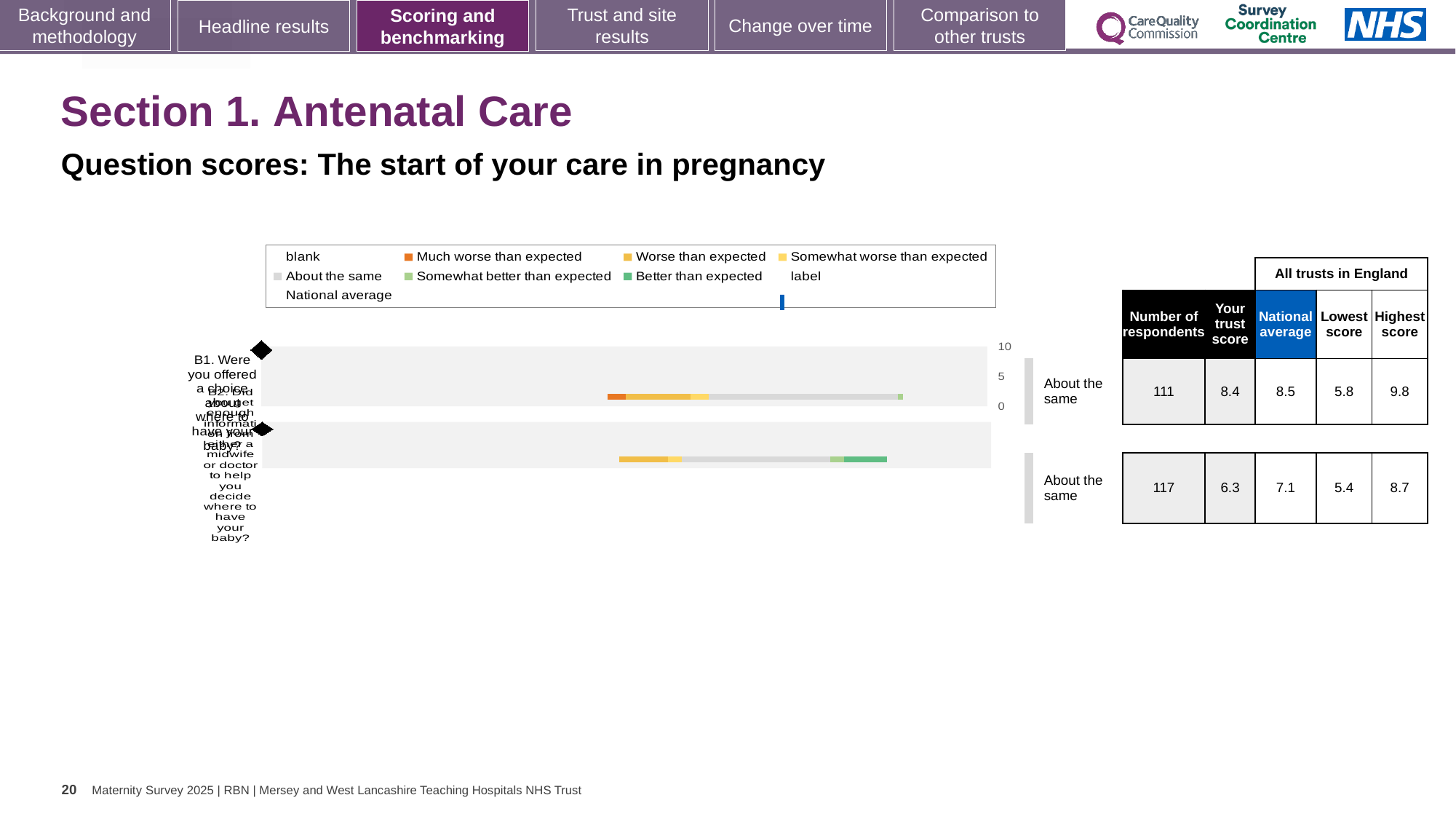
How many questions (bars) are plotted in the chart? 2 What kind of chart is shown on the slide? bar chart How many respondents answered question B1? 111 What is the highest score among all trusts in England for question B2? 8.7 What is the trust score for the second question, B2? 6.3 Which question had more respondents, B1 or B2? B2 What benchmark category is given for question B2? About the same What is the national average for question B1? 8.5 What is the trust score for question B1 (Were you offered a choice about where to have your baby?)? 8.4 What is the difference between the highest score and the lowest score for question B1? 4.0 Which legend entry is shown in orange? Much worse than expected What is the highest value shown on the chart's score axis? 10